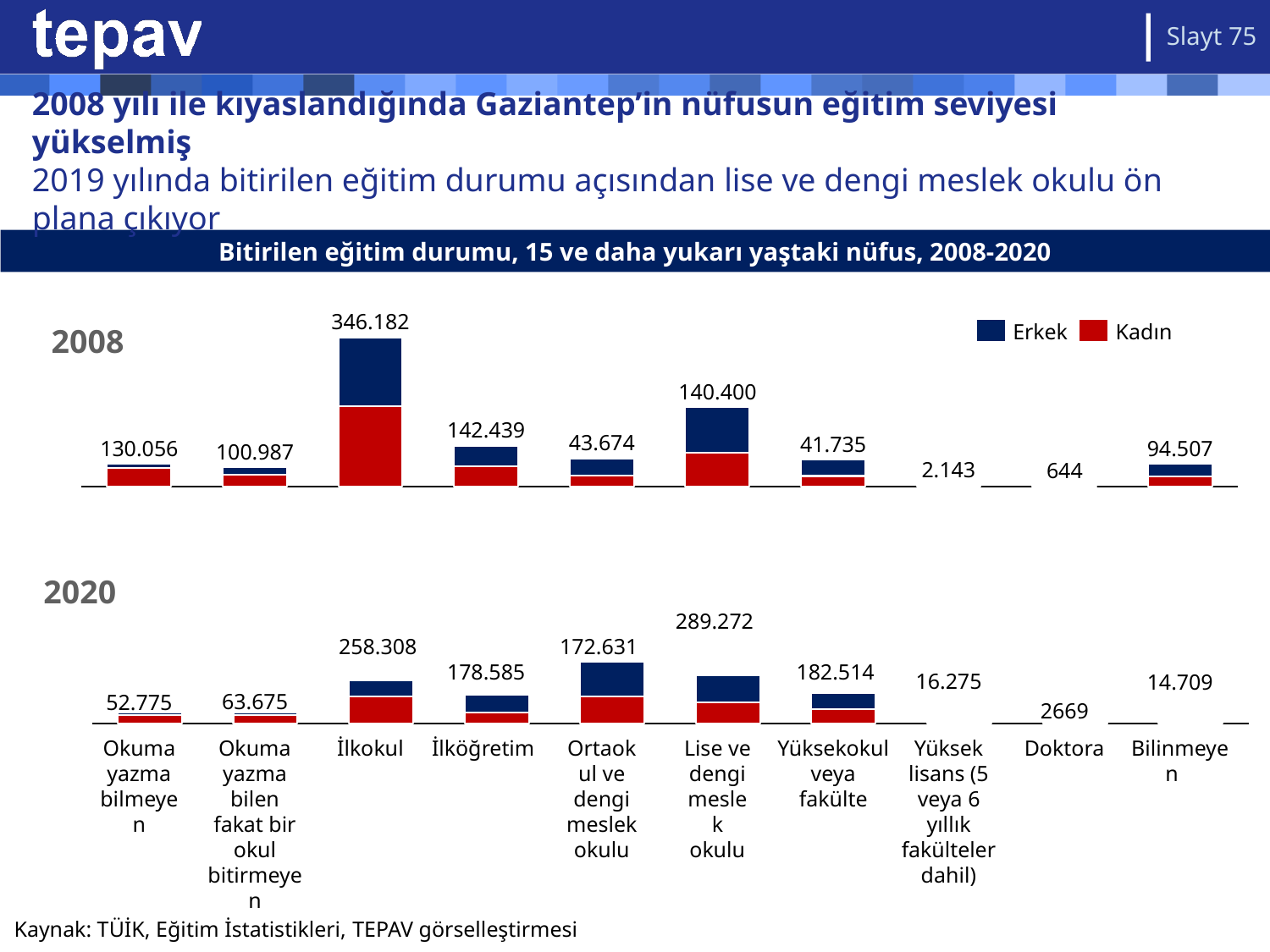
How many categories are shown along the x axis of the 2020 chart? 10 What kind of chart is the 2008 chart? Stacked bar chart In the 2020 chart, what is the difference between the totals for Yüksekokul veya fakülte and İlköğretim? 3.929 In the 2008 chart, what is the total value shown for İlkokul? 346.182 In the 2020 chart, which category has the lowest total? Doktora How many series does the legend list? 2 In the 2020 chart, which is larger: the total for İlkokul or the total for Lise ve dengi meslek okulu? Lise ve dengi meslek okulu In the 2008 chart, which category has the highest total? İlkokul In the 2008 chart, what is the total value shown for Doktora? 644 In the 2020 chart, what is the total value shown for Yüksek lisans (5 veya 6 yıllık fakülteler dahil)? 16.275 What are the two series named in the legend? Erkek and Kadın In the 2020 chart, what is the total value shown for Lise ve dengi meslek okulu? 289.272